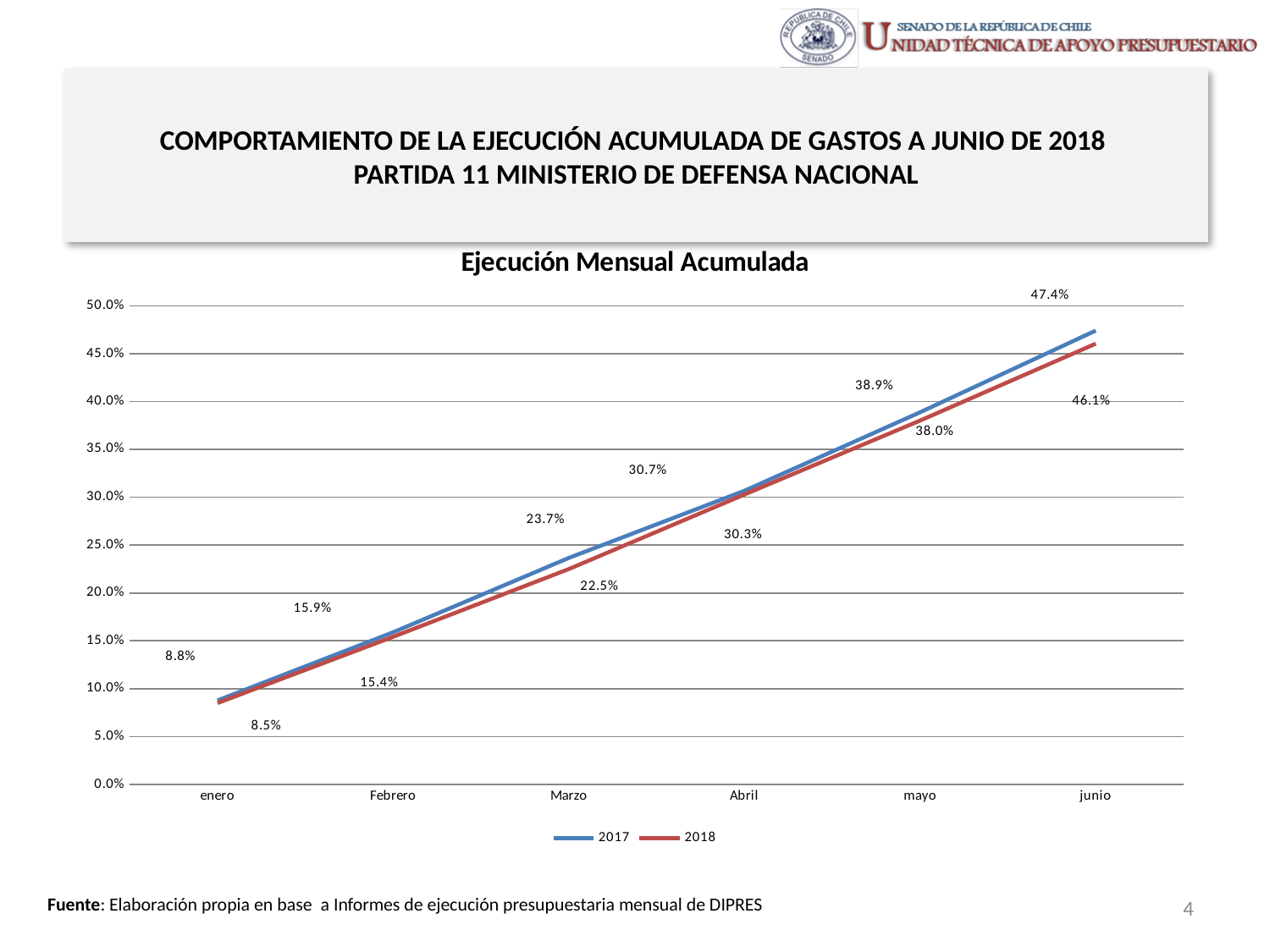
What is the title of the chart? Ejecución Mensual Acumulada Which series is drawn in red? 2018 How many series does the legend list? 2 What is the value for 2017 in mayo? 38.9% What is the value for 2018 in enero? 8.5% How many months are shown on the x axis? 6 Which month has the lowest value for the 2017 series? enero Do the values for 2018 rise or fall from enero to junio? rise What is the value for 2018 in Marzo? 22.5% What type of chart is shown on the slide? line chart What is the difference between the 2017 and 2018 values in junio? 1.3% What is the value for 2017 in junio? 47.4%